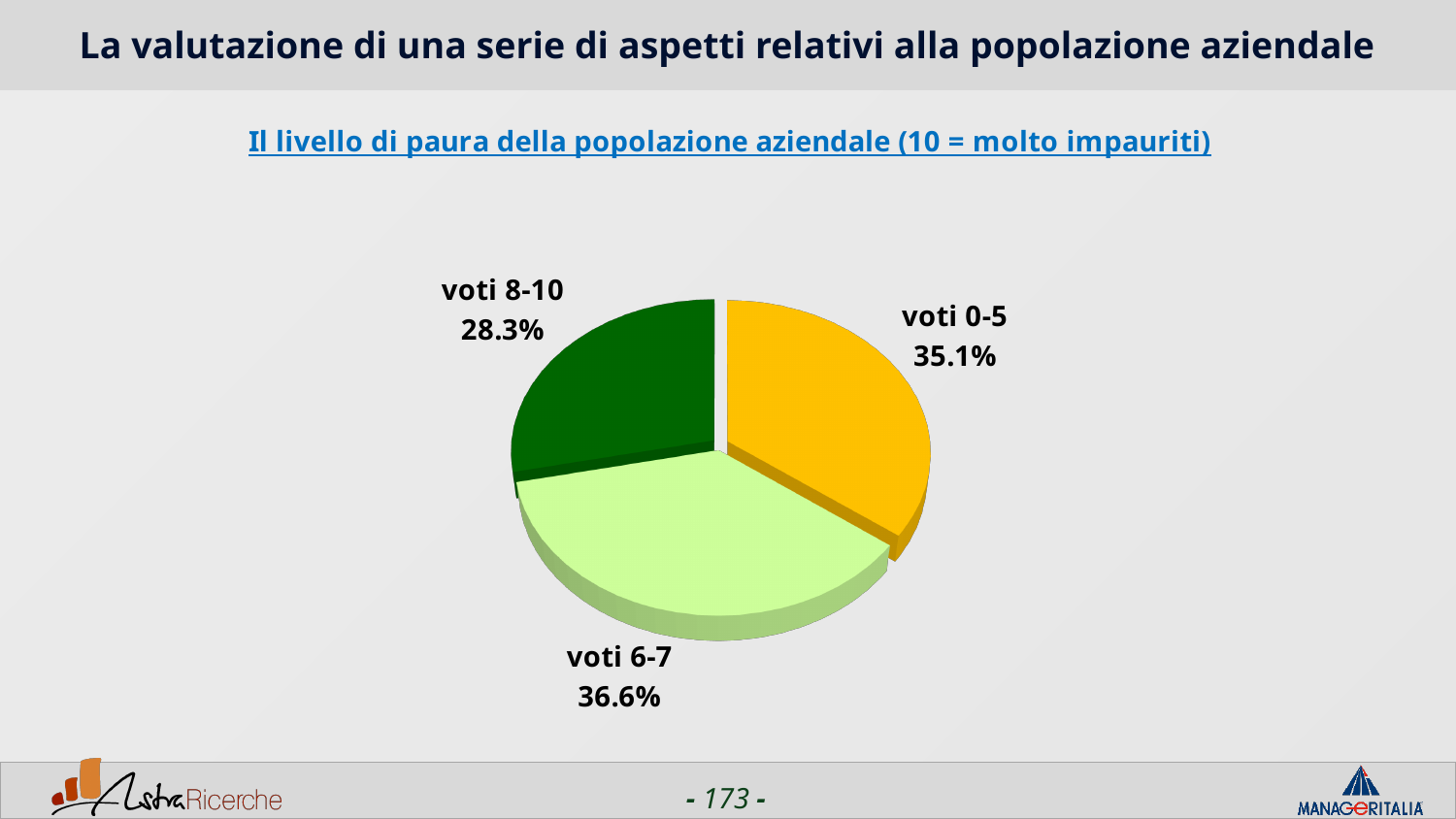
What is the difference in percentage points between the "voti 6-7" slice and the "voti 8-10" slice? 8.3 What is the title of the pie chart? Il livello di paura della popolazione aziendale (10 = molto impauriti) What kind of chart is shown on the slide? pie chart Which slice of the pie is the largest? voti 6-7 Which is larger, the "voti 0-5" slice or the "voti 8-10" slice? voti 0-5 What share of the pie is labelled "voti 8-10"? 28.3% What share of the pie is labelled "voti 6-7"? 36.6% How many slices does the pie chart have? 3 What is the difference in percentage points between the "voti 0-5" slice and the "voti 8-10" slice? 6.8 Which slice of the pie is the smallest? voti 8-10 What share of the pie is labelled "voti 0-5"? 35.1% What colour is the "voti 0-5" slice of the pie? orange/yellow